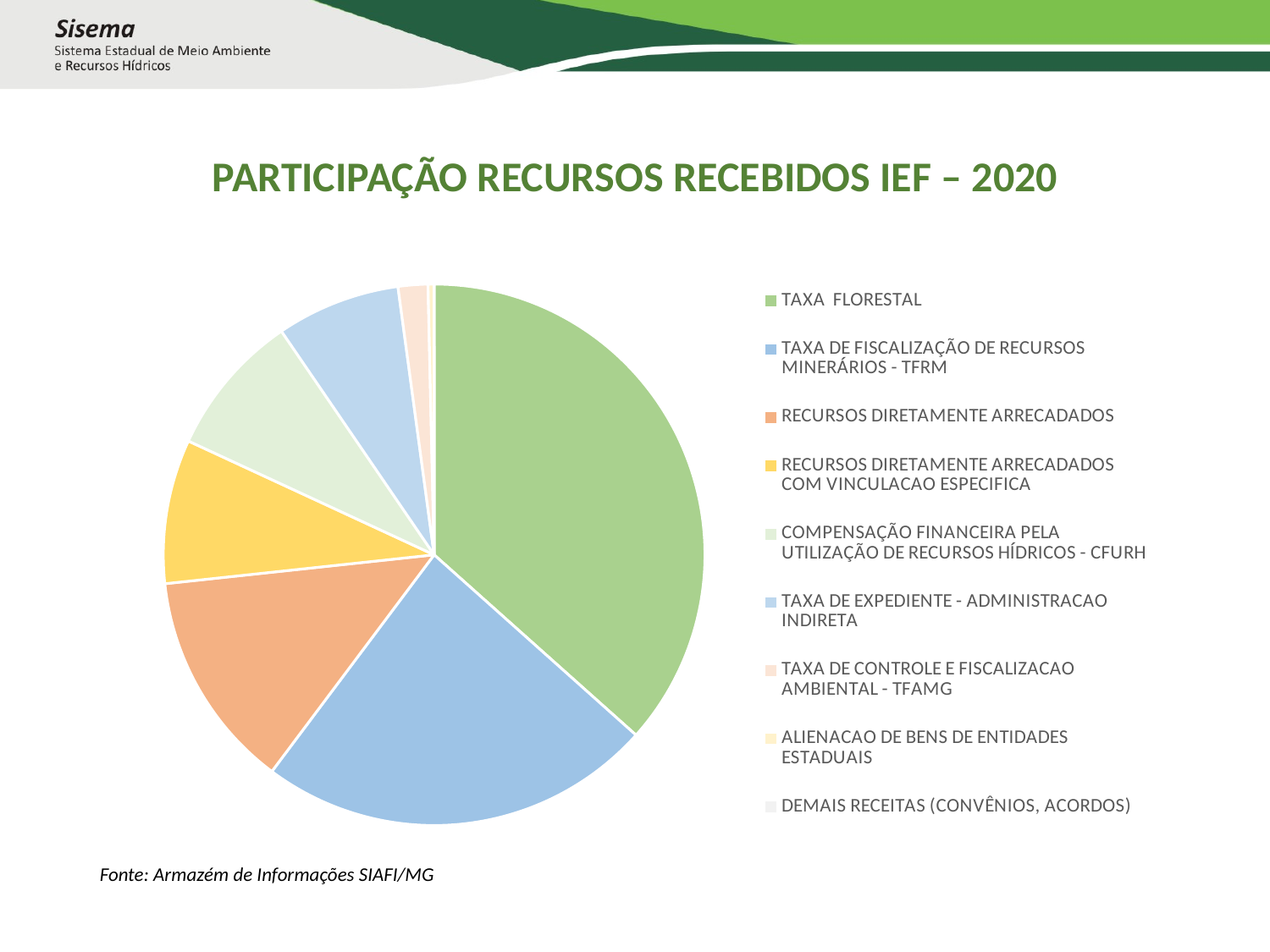
Which slice is larger: TAXA DE EXPEDIENTE - ADMINISTRACAO INDIRETA or TAXA DE CONTROLE E FISCALIZACAO AMBIENTAL - TFAMG? TAXA DE EXPEDIENTE - ADMINISTRACAO INDIRETA Which slice is larger: TAXA DE FISCALIZAÇÃO DE RECURSOS MINERÁRIOS - TFRM or RECURSOS DIRETAMENTE ARRECADADOS? TAXA DE FISCALIZAÇÃO DE RECURSOS MINERÁRIOS - TFRM What colour is the TAXA FLORESTAL slice? Green How many categories does the legend list? 9 What is the title of the chart? PARTICIPAÇÃO RECURSOS RECEBIDOS IEF – 2020 Which slice is larger: COMPENSAÇÃO FINANCEIRA PELA UTILIZAÇÃO DE RECURSOS HÍDRICOS - CFURH or TAXA DE CONTROLE E FISCALIZACAO AMBIENTAL - TFAMG? COMPENSAÇÃO FINANCEIRA PELA UTILIZAÇÃO DE RECURSOS HÍDRICOS - CFURH Which category has the largest slice of the pie? TAXA FLORESTAL What kind of chart is shown on the slide? Pie chart